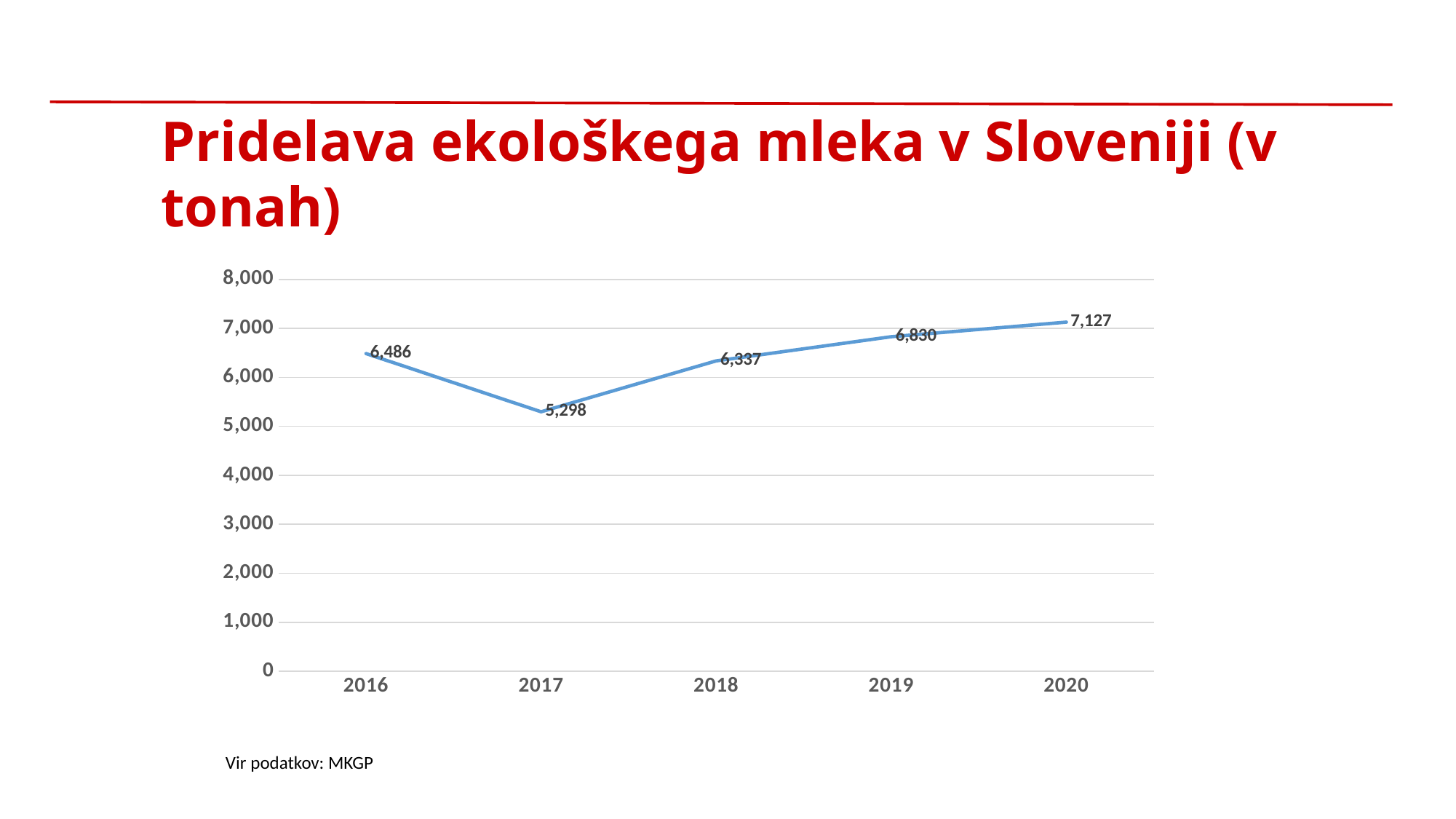
What value is shown for 2017? 5,298 How many years are plotted on the chart? 5 Do the values rise or fall from 2017 to 2020? rise What value is shown for 2020? 7,127 What was the production of organic milk in Slovenia in 2016? 6,486 Is the value for 2019 greater or less than 7,000? less What is the difference between the values for 2020 and 2016? 641 Which is larger, the value for 2019 or the value for 2018? 2019 What kind of chart is shown on the slide? line chart Which year has the lowest value? 2017 Which year has the highest value? 2020 What is the difference between the values for 2018 and 2017? 1,039